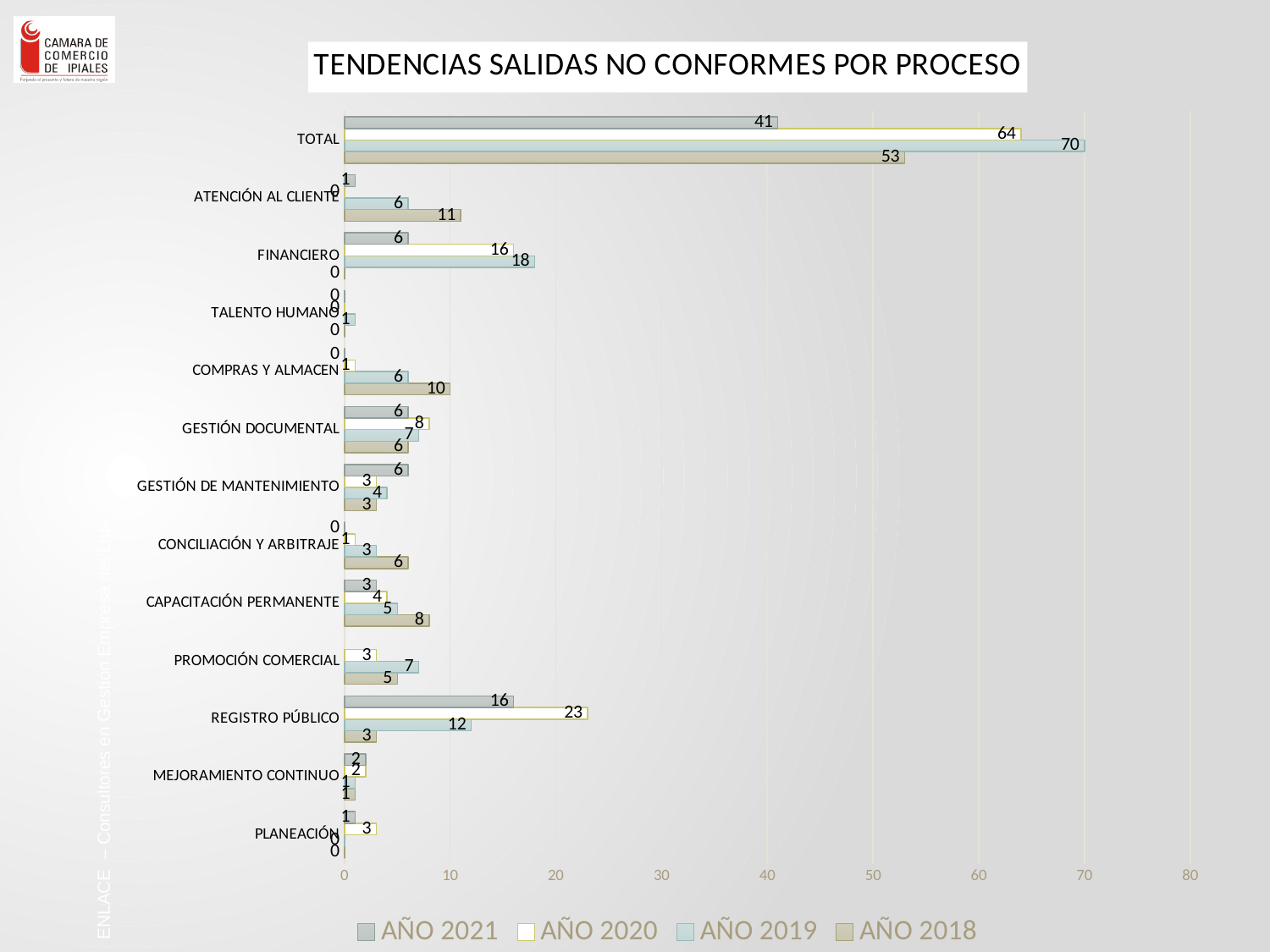
What is the TOTAL value for AÑO 2019? 70 What type of chart is shown on the slide? Bar chart What is the value for FINANCIERO in AÑO 2019? 18 How many categories are shown on the y axis? 13 Which year has the highest TOTAL value? AÑO 2019 What is the value for REGISTRO PÚBLICO in AÑO 2020? 23 How many series does the legend list? 4 Is the TOTAL value for AÑO 2018 greater or less than 50? greater What is the value for ATENCIÓN AL CLIENTE in AÑO 2018? 11 What is the difference between the TOTAL values for AÑO 2020 and AÑO 2021? 23 Which year has the lowest TOTAL value? AÑO 2021 Which is larger for REGISTRO PÚBLICO: the AÑO 2021 value or the AÑO 2019 value? AÑO 2021